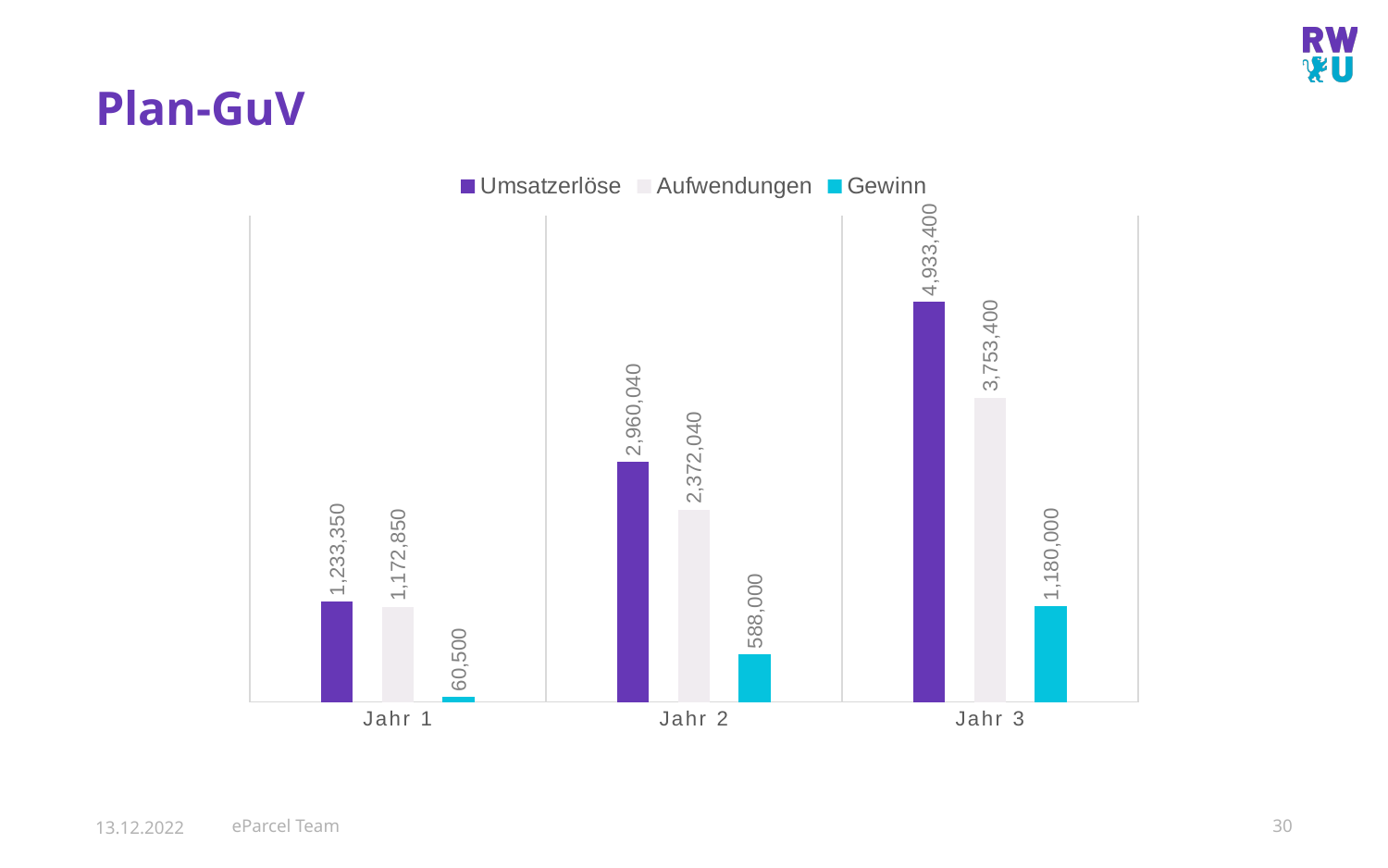
How many series does the legend list? 3 Which is larger: Aufwendungen in Jahr 2 or Umsatzerlöse in Jahr 1? Aufwendungen in Jahr 2 How many years (categories) are shown on the x axis? 3 What is the Umsatzerlöse value for Jahr 2? 2,960,040 Do the Gewinn values rise or fall from Jahr 1 to Jahr 3? Rise What is the difference between Umsatzerlöse and Aufwendungen in Jahr 3? 1,180,000 Which year has the lowest Gewinn? Jahr 1 Which year has the highest Umsatzerlöse? Jahr 3 What is the Gewinn value for Jahr 1? 60,500 What is the difference between Gewinn in Jahr 2 and Gewinn in Jahr 1? 527,500 What is the Aufwendungen value for Jahr 3? 3,753,400 What kind of chart is shown on the slide? Bar chart